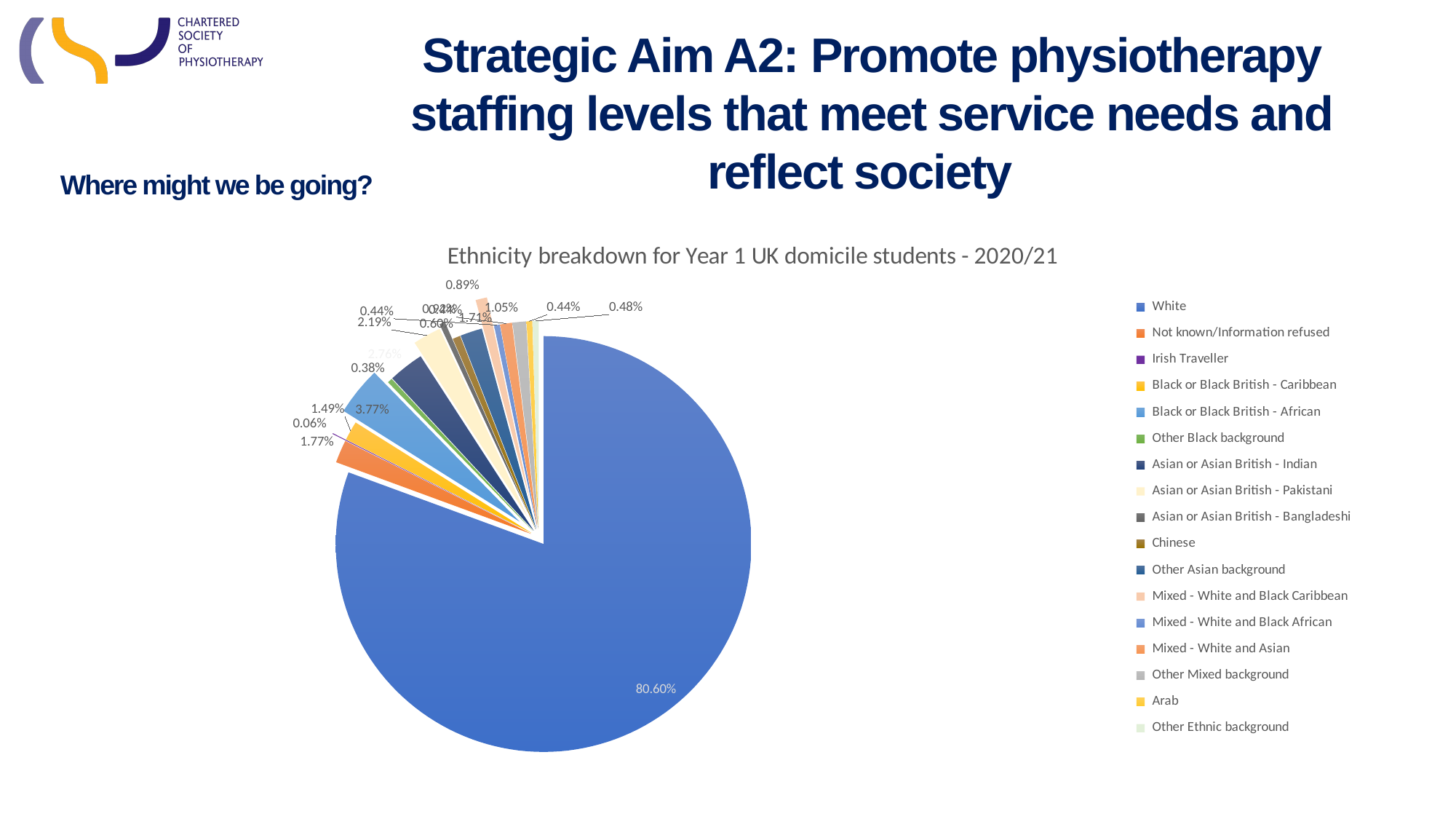
What percentage is shown for Irish Traveller? 0.06% Which is larger: the share for Black or Black British - African or the share for Black or Black British - Caribbean? Black or Black British - African What is the title of the chart? Ethnicity breakdown for Year 1 UK domicile students - 2020/21 What percentage is shown for Not known/Information refused? 1.77% What type of chart is shown on the slide? pie chart Which ethnicity category has the largest share of the pie? White How many ethnicity categories are listed in the legend? 17 Which ethnicity category has the smallest share of the pie? Irish Traveller What percentage is shown for Black or Black British - African? 3.77% What percentage of Year 1 UK domicile students are White? 80.60% What is the difference in percentage points between the White share and the Black or Black British - African share? 76.83% What percentage is shown for Arab? 0.44%